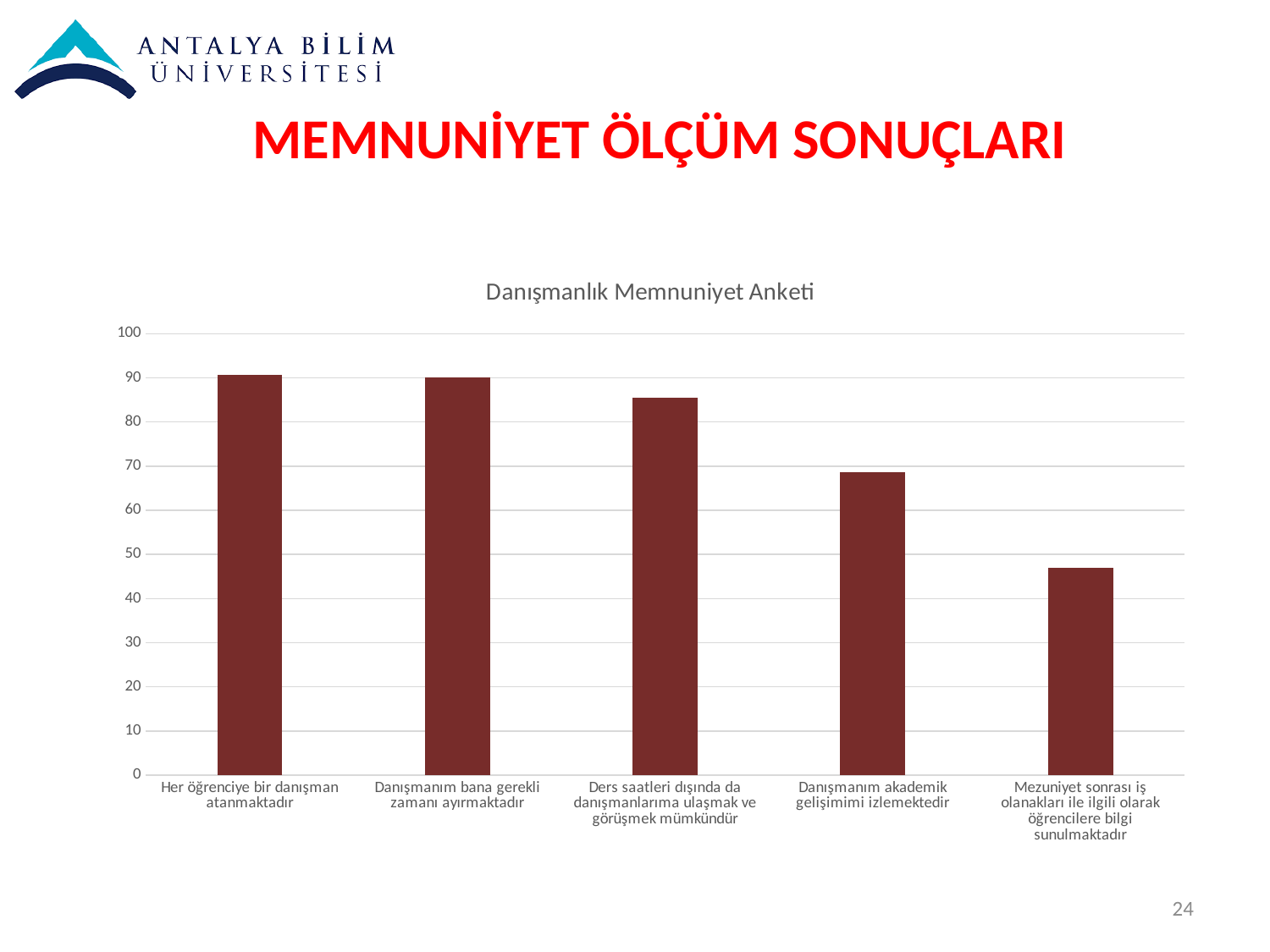
Is the value for 'Danışmanım akademik gelişimimi izlemektedir' greater or less than 60? greater Which is larger: the value for 'Danışmanım akademik gelişimimi izlemektedir' or the value for 'Mezuniyet sonrası iş olanakları ile ilgili olarak öğrencilere bilgi sunulmaktadır'? Danışmanım akademik gelişimimi izlemektedir Is the value for 'Ders saatleri dışında da danışmanlarıma ulaşmak ve görüşmek mümkündür' greater or less than 90? less Which is larger: the value for 'Her öğrenciye bir danışman atanmaktadır' or the value for 'Danışmanım akademik gelişimimi izlemektedir'? Her öğrenciye bir danışman atanmaktadır Is the value for 'Mezuniyet sonrası iş olanakları ile ilgili olarak öğrencilere bilgi sunulmaktadır' greater or less than 40? greater What kind of chart is shown on the slide? bar chart How many categories are shown in the chart? 5 Which category has the lowest value? Mezuniyet sonrası iş olanakları ile ilgili olarak öğrencilere bilgi sunulmaktadır What is the title of the chart? Danışmanlık Memnuniyet Anketi Do the values rise or fall from left to right across the categories? fall